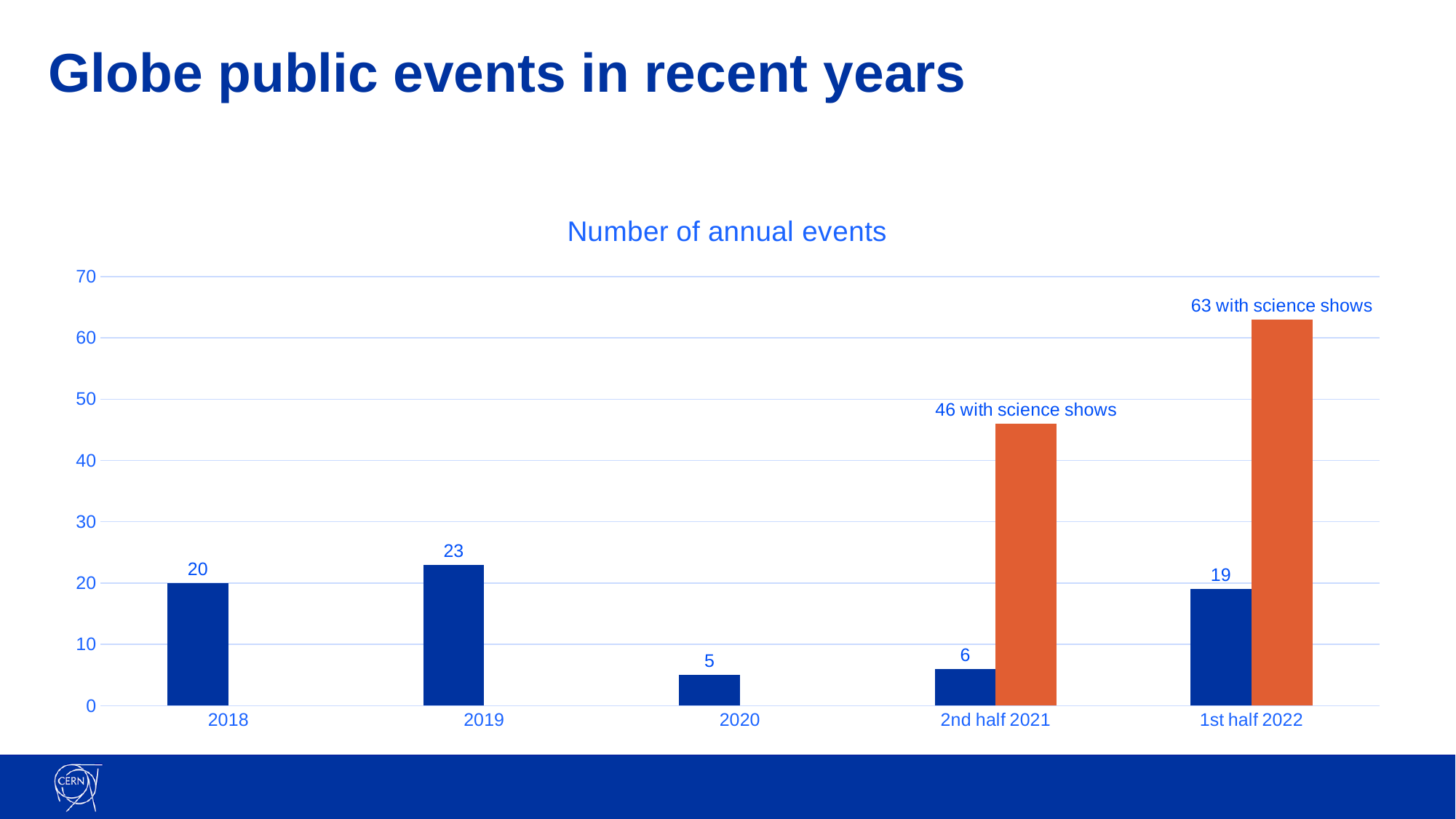
What is the difference between the orange bars for 1st half 2022 and 2nd half 2021? 17 What is the difference between the blue bars for 2019 and 2018? 3 What is the number of events for 2019 (blue bar)? 23 How many categories are shown on the x axis? 5 What is the value of the blue bar for 2nd half 2021? 6 Which category has the lowest blue bar? 2020 Which category has the tallest bar overall? 1st half 2022 What is the title of the chart? Number of annual events Which is larger, the blue bar for 2018 or the blue bar for 1st half 2022? 2018 What type of chart is shown on the slide? bar chart What is the value of the orange bar for 1st half 2022? 63 What is the number of events for 2020? 5